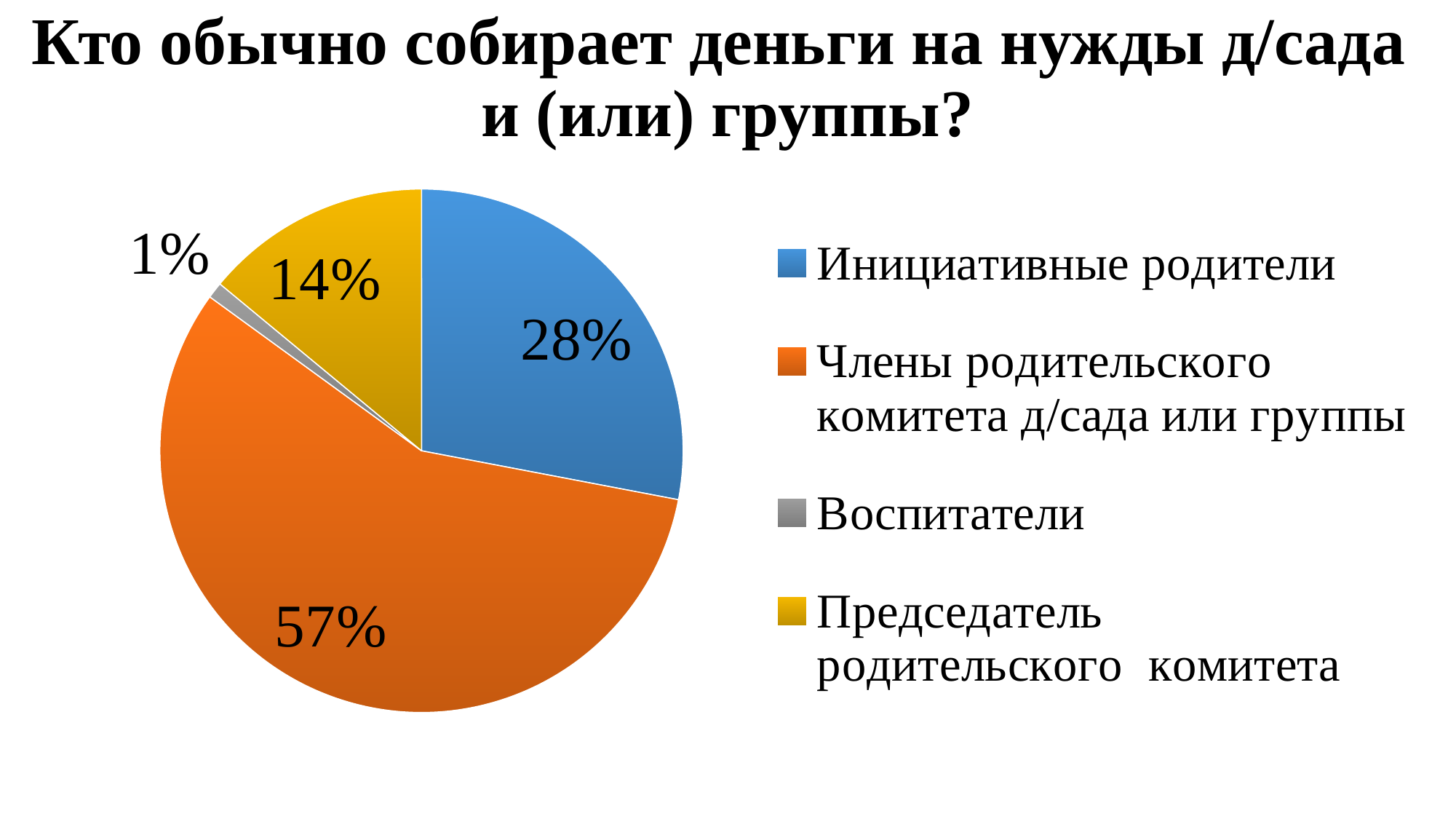
How many categories does the pie chart have? 4 What colour is the slice for Воспитатели? grey What type of chart is shown on the slide? pie chart Which is larger: the slice for Инициативные родители or the slice for Председатель родительского комитета? Инициативные родители What share of the pie is labelled for Члены родительского комитета д/сада или группы? 57% What is the title of the slide? Кто обычно собирает деньги на нужды д/сада и (или) группы? Which category has the largest slice of the pie? Члены родительского комитета д/сада или группы Which category has the smallest slice of the pie? Воспитатели What share of the pie is labelled for Председатель родительского комитета? 14% What share of the pie is labelled for Инициативные родители? 28% What is the difference in percentage points between Члены родительского комитета д/сада или группы and Инициативные родители? 29 What share of the pie is labelled for Воспитатели? 1%